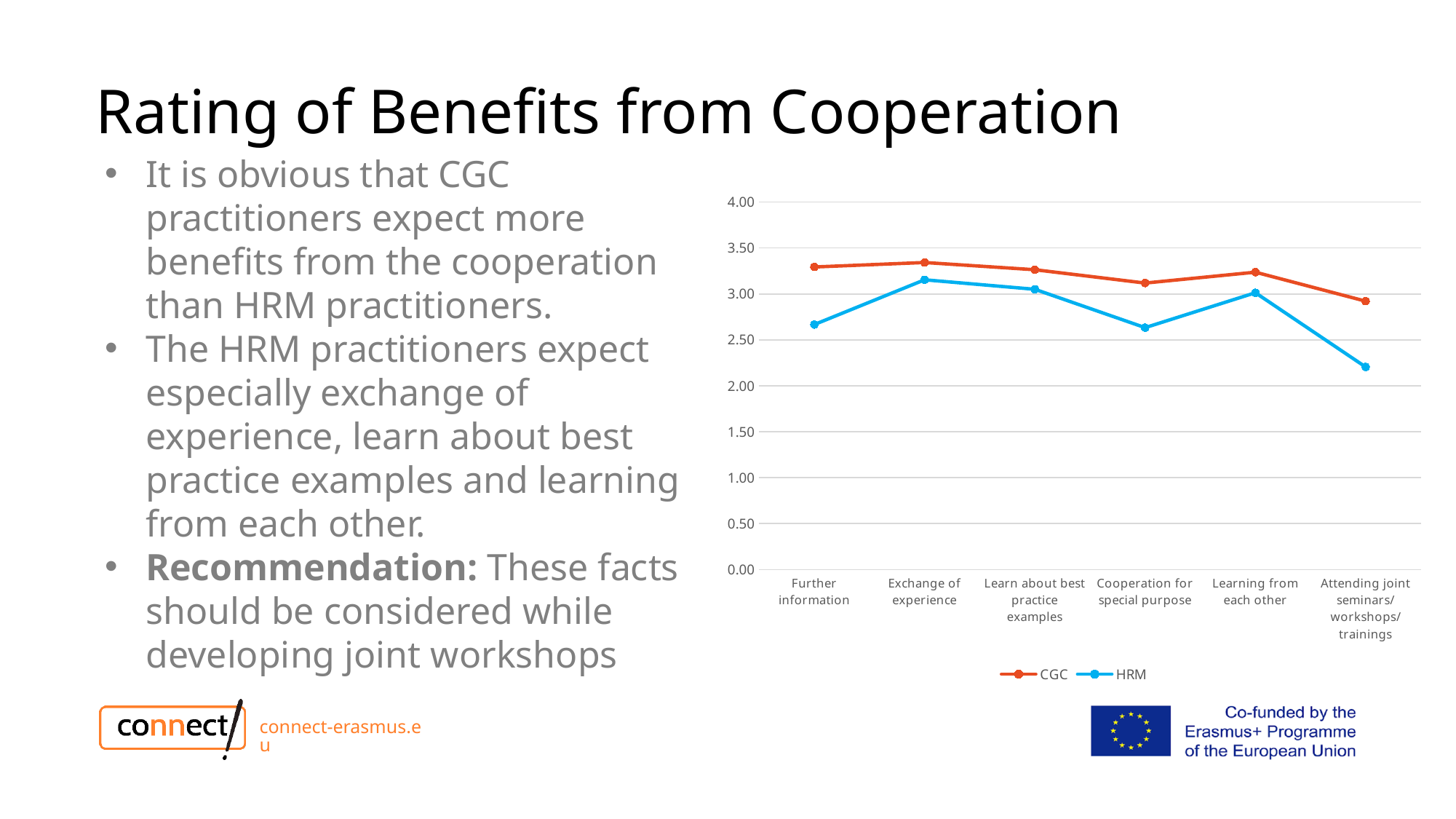
For which category is the HRM series lowest? Attending joint seminars/workshops/trainings What kind of chart is shown on the slide? line chart How many categories are shown along the x axis of the chart? 6 How many series does the chart legend list? 2 For which category is the HRM series highest? Exchange of experience Which colour is used for the HRM series in the chart? blue For which category is the CGC series lowest? Attending joint seminars/workshops/trainings Is the HRM value for Further information greater or less than 3.00? less Which series has the larger value for Further information, CGC or HRM? CGC Does the HRM series rise or fall from Learning from each other to Attending joint seminars/workshops/trainings? fall Is the HRM value for Attending joint seminars/workshops/trainings greater or less than 2.50? less Is the CGC value for Further information greater or less than 3.00? greater